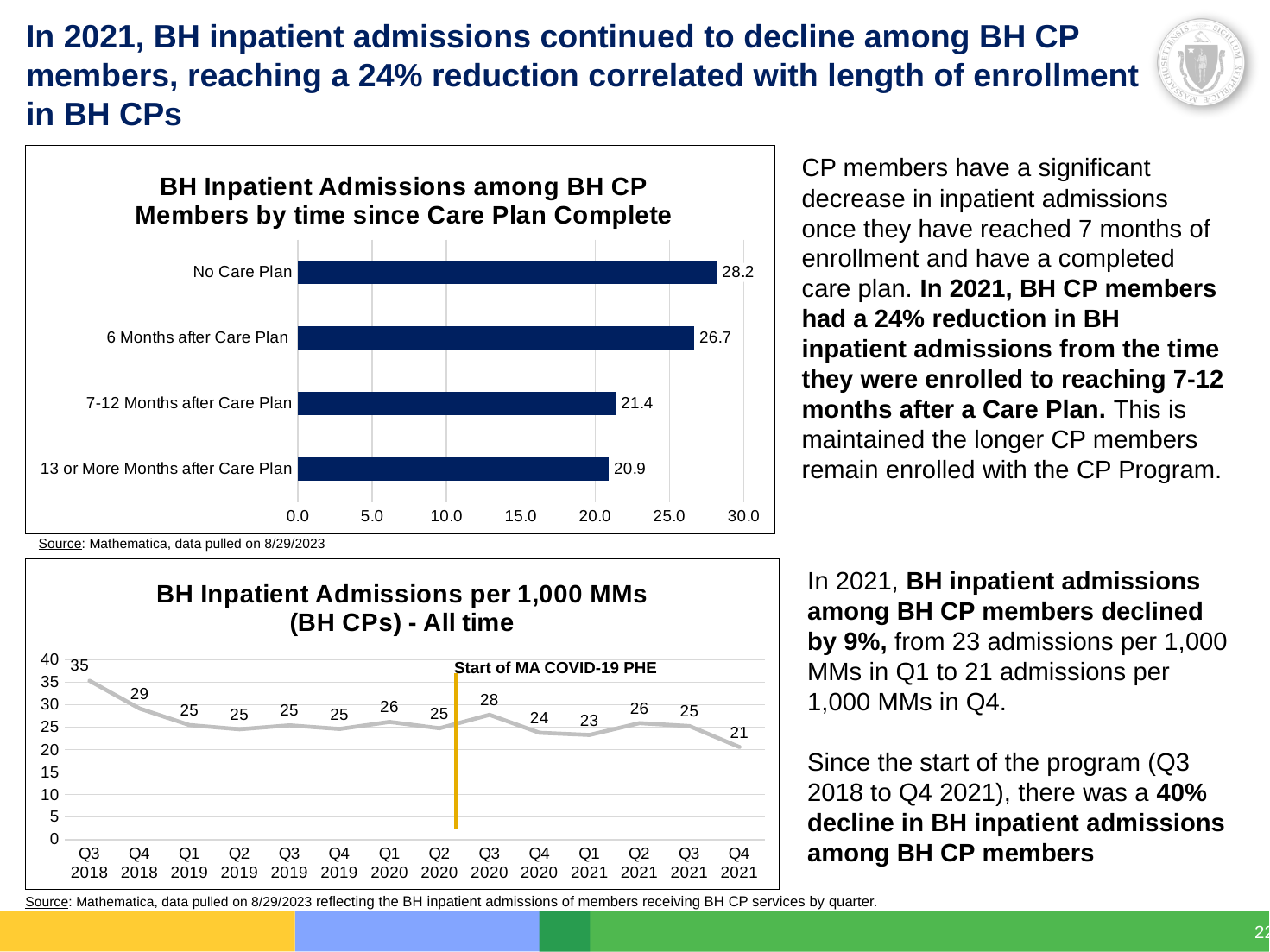
In the chart 'BH Inpatient Admissions per 1,000 MMs (BH CPs) - All time', what is the value for Q4 2021? 21 In the chart 'BH Inpatient Admissions among BH CP Members by time since Care Plan Complete', which category has the lowest value? 13 or More Months after Care Plan In the chart 'BH Inpatient Admissions per 1,000 MMs (BH CPs) - All time', which quarter has the highest value? Q3 2018 In the chart 'BH Inpatient Admissions among BH CP Members by time since Care Plan Complete', what is the difference between 'No Care Plan' and '13 or More Months after Care Plan'? 7.3 In the chart 'BH Inpatient Admissions among BH CP Members by time since Care Plan Complete', what is the value for 'No Care Plan'? 28.2 In the chart 'BH Inpatient Admissions among BH CP Members by time since Care Plan Complete', how many categories are shown? 4 What kind of chart is 'BH Inpatient Admissions among BH CP Members by time since Care Plan Complete'? Bar chart In the chart 'BH Inpatient Admissions per 1,000 MMs (BH CPs) - All time', which is larger, the value for Q3 2020 or the value for Q1 2021? Q3 2020 In the chart 'BH Inpatient Admissions per 1,000 MMs (BH CPs) - All time', what is the value for Q3 2018? 35 In the chart 'BH Inpatient Admissions per 1,000 MMs (BH CPs) - All time', how many data points are plotted? 14 In the chart 'BH Inpatient Admissions per 1,000 MMs (BH CPs) - All time', what event does the vertical orange line mark? Start of MA COVID-19 PHE In the chart 'BH Inpatient Admissions among BH CP Members by time since Care Plan Complete', what is the value for '7-12 Months after Care Plan'? 21.4